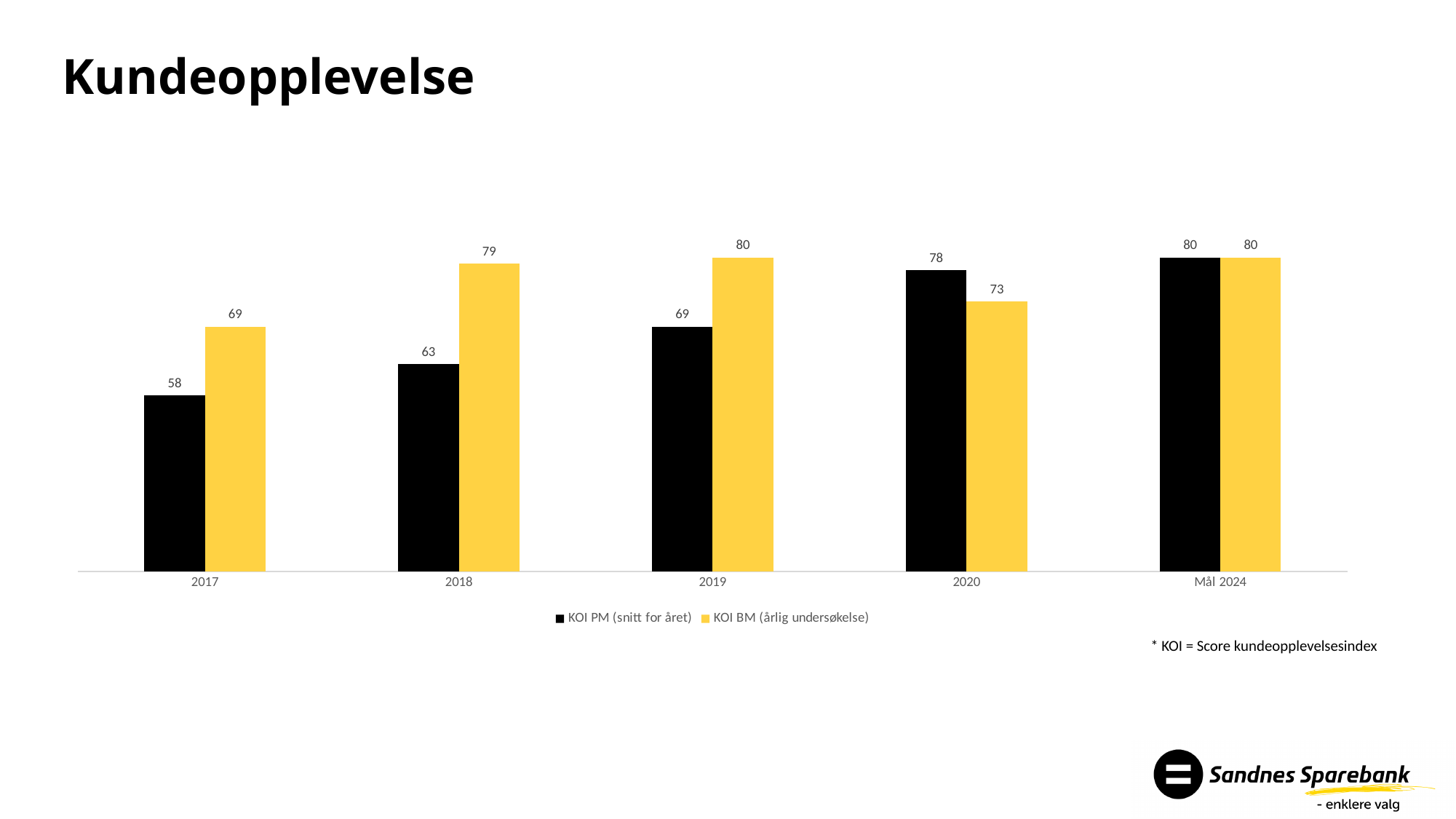
Which category has the lowest value for KOI BM (årlig undersøkelse)? 2017 Which year has the lowest value for KOI PM (snitt for året)? 2017 What is the difference between KOI BM (årlig undersøkelse) and KOI PM (snitt for året) in 2018? 16 What is the value of KOI BM (årlig undersøkelse) for 2020? 73 What is the value of KOI PM (snitt for året) for Mål 2024? 80 What is the value of KOI BM (årlig undersøkelse) for 2018? 79 How many categories are shown on the x axis? 5 What kind of chart is shown on the slide? Bar chart How many series does the legend list? 2 Does KOI PM (snitt for året) rise or fall from 2017 to 2020? Rise What is the value of KOI PM (snitt for året) for 2017? 58 Which is larger in 2020, KOI PM (snitt for året) or KOI BM (årlig undersøkelse)? KOI PM (snitt for året)